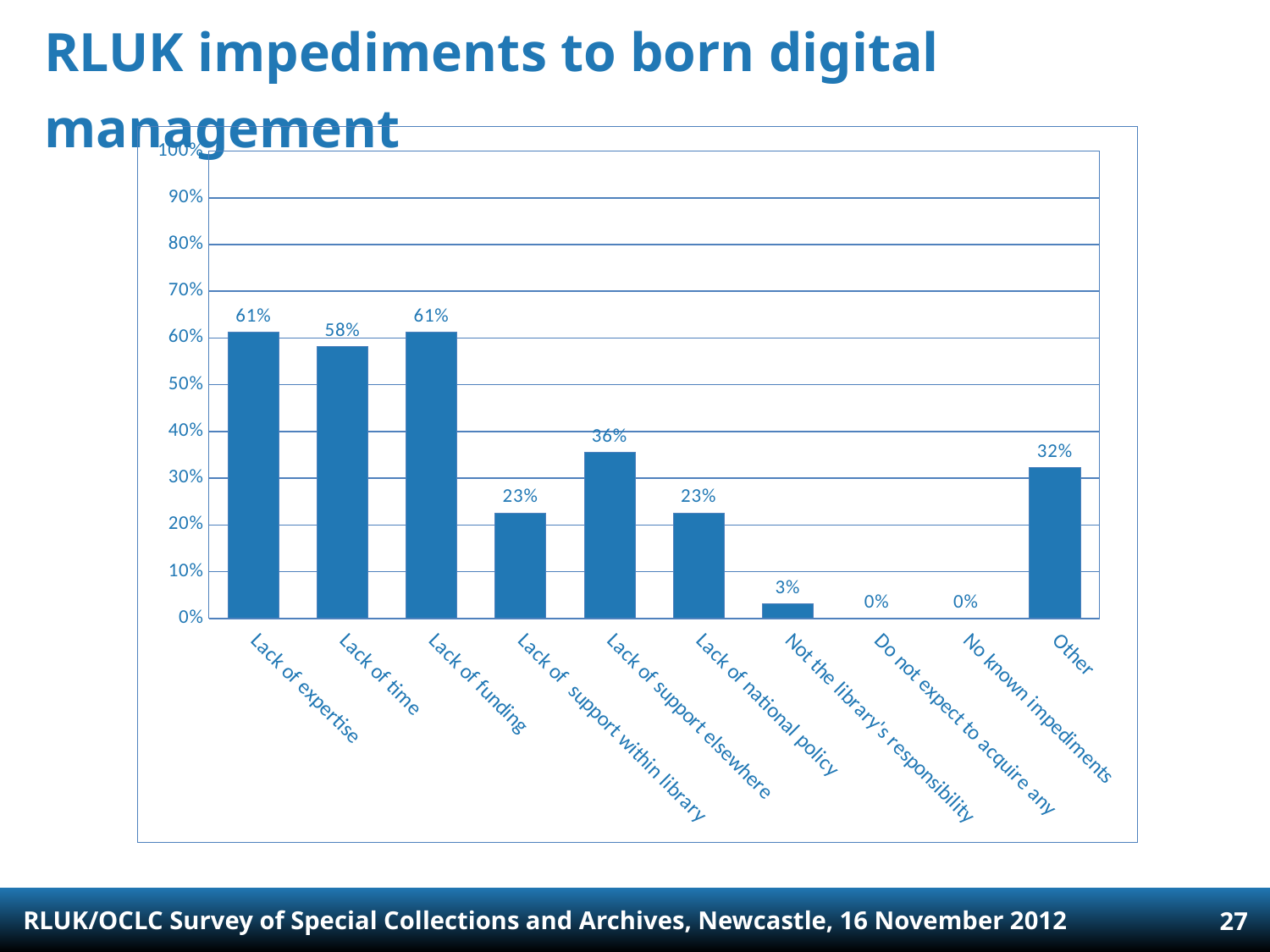
How many categories are shown on the x axis? 10 What is the value for Other? 32% Which is larger, the value for Lack of time or the value for Lack of support within library? Lack of time What is the difference between the values for Lack of expertise and Other? 29% What is the value for Lack of national policy? 23% What kind of chart is shown on the slide? Bar chart What is the difference between the values for Lack of time and Lack of support elsewhere? 22% What is the value for Lack of support elsewhere? 36% What is the value for Lack of time? 58% How many categories have a value of 0%? 2 What is the value for Not the library's responsibility? 3% Which is larger, the value for Lack of support elsewhere or the value for Other? Lack of support elsewhere